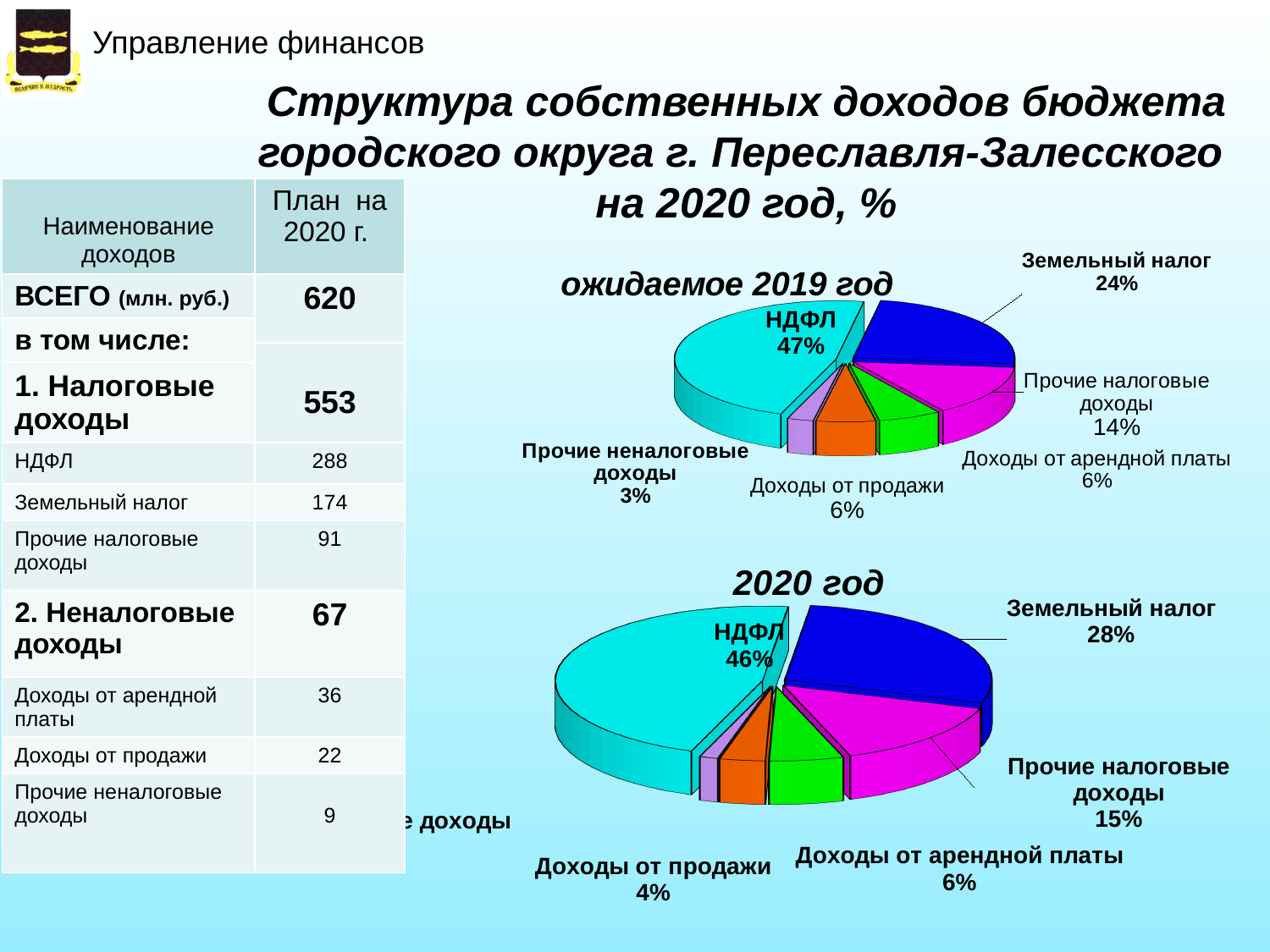
In the pie chart titled '2020 год', which is larger: Доходы от арендной платы or Доходы от продажи? Доходы от арендной платы In the pie chart titled 'ожидаемое 2019 год', which category has the smallest share? Прочие неналоговые доходы What type of chart is used for the '2020 год' chart? Pie chart In the pie chart titled '2020 год', what share does Земельный налог have? 28% In the pie chart titled 'ожидаемое 2019 год', what share does НДФЛ have? 47% In the pie chart titled '2020 год', what is the difference in percentage points between НДФЛ and Земельный налог? 18 In the pie chart titled 'ожидаемое 2019 год', which is larger: Земельный налог or Прочие налоговые доходы? Земельный налог In the pie chart titled '2020 год', which category has the largest share? НДФЛ In the pie chart titled 'ожидаемое 2019 год', which category has the largest share? НДФЛ In the pie chart titled 'ожидаемое 2019 год', what is the share of Прочие налоговые доходы? 14% In the pie chart titled '2020 год', what is the share of Доходы от продажи? 4% How many slices does the pie chart titled 'ожидаемое 2019 год' have? 6